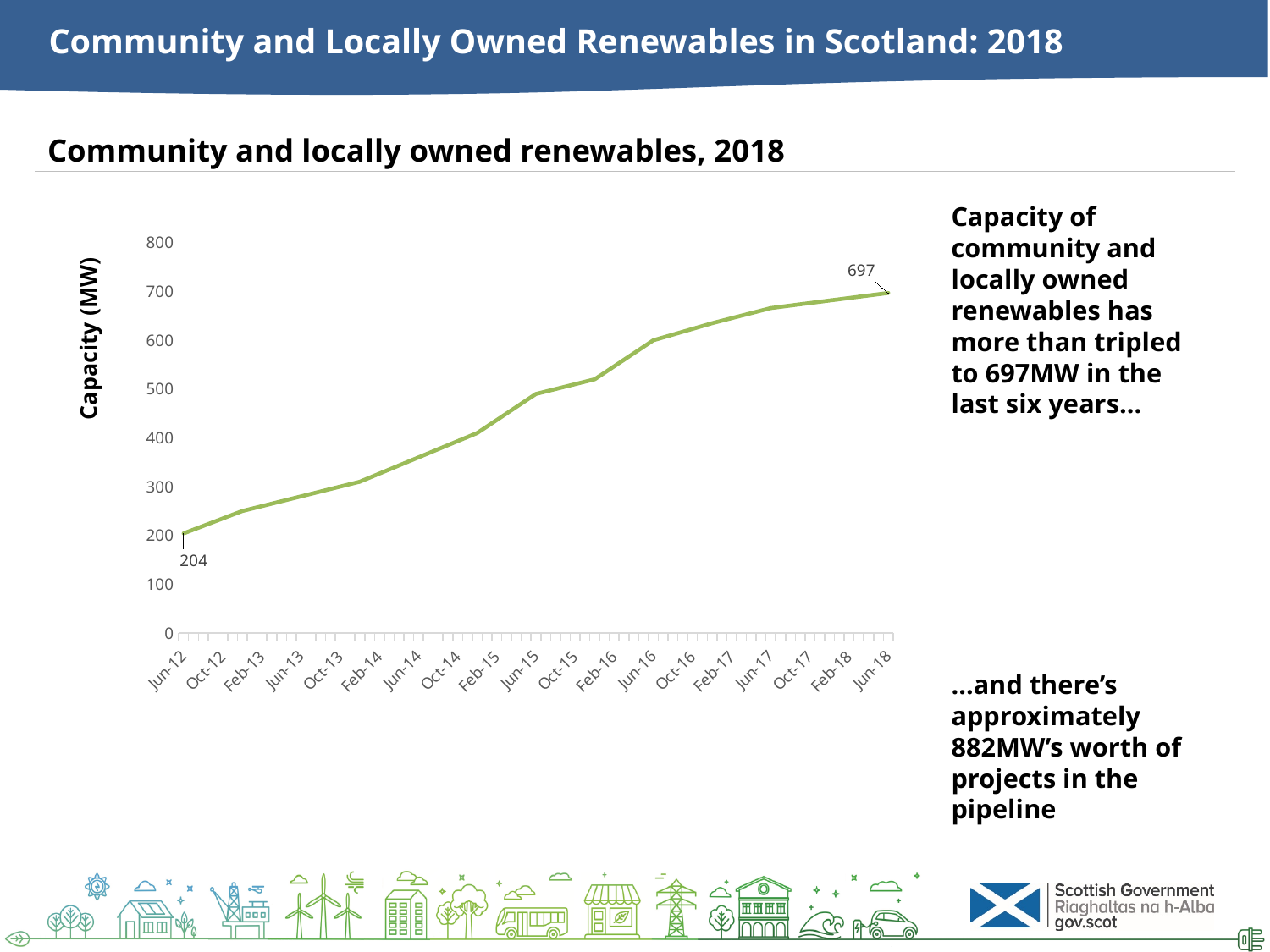
Is the value for Jun-14 greater or less than 300? greater Which of the two labelled points, Jun-12 or Jun-18, has the larger value? Jun-18 At which date does the line reach its highest value? Jun-18 What is the difference between the labelled values at Jun-18 and Jun-12? 493 Is the value for Jun-17 greater or less than 600? greater What is the title of the vertical axis? Capacity (MW) What is the capacity value labelled at Jun-12? 204 What is the capacity value labelled at Jun-18? 697 Does the capacity rise or fall from Jun-12 to Jun-18? rise What type of chart is shown on the slide? line chart At which date does the line have its lowest value? Jun-12 Is the value for Jun-13 greater or less than 300? less